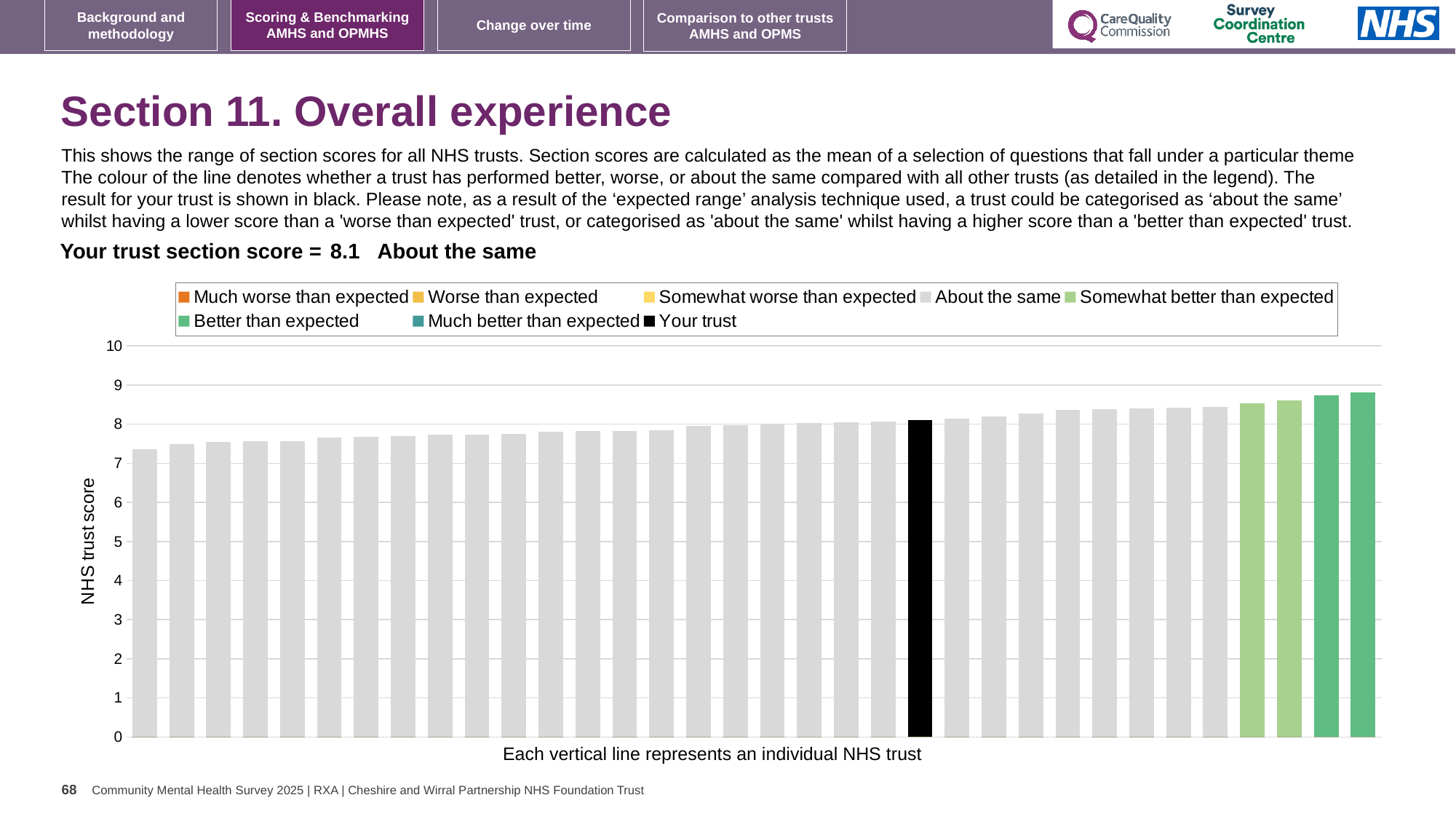
Is the value of the leftmost bar greater or less than 8? less How many bars are coloured as 'Better than expected' (darker green)? 2 Is the value of the black 'Your trust' bar greater or less than 8? greater What is the section score for your trust shown on the slide? 8.1 Is the black 'Your trust' bar taller or shorter than the leftmost bar? taller What is the label on the vertical axis of the chart? NHS trust score How many entries does the chart legend list? 8 Is the value of the tallest bar greater or less than 9? less Do the bar values rise or fall from left to right across the chart? rise Which category is your trust placed in for this section? About the same What kind of chart is shown on the slide? bar chart How many bars are coloured as 'Somewhat better than expected' (light green)? 2